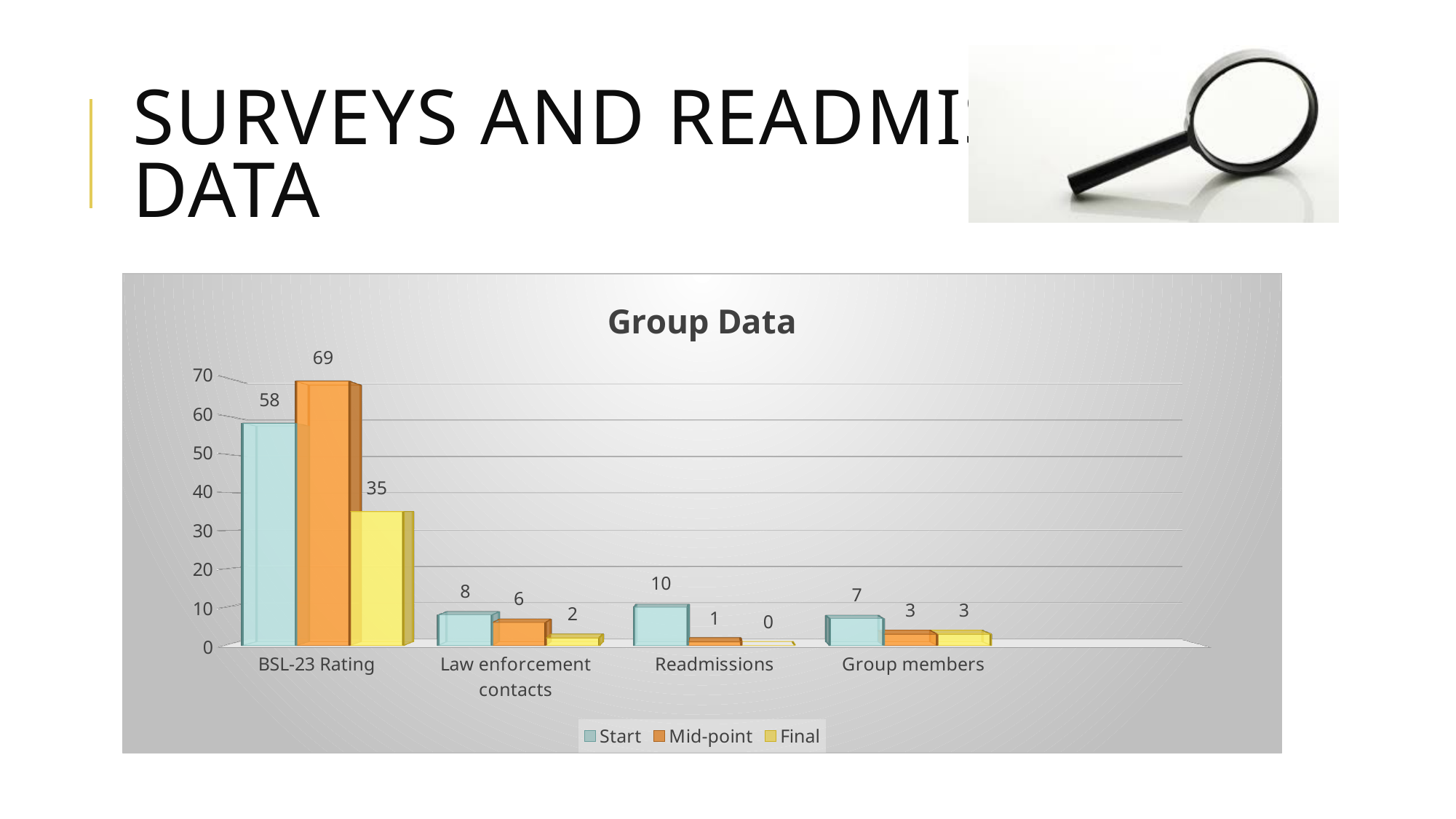
How many series does the legend list? 3 How many categories are shown on the x axis? 4 What is the title of the chart? Group Data Which category has the lowest Final value? Readmissions What is the Final value for Readmissions? 0 What is the Mid-point value for BSL-23 Rating? 69 Which category has the highest Start value? BSL-23 Rating What is the difference between the Start and Final values for BSL-23 Rating? 23 What is the Final value for Law enforcement contacts? 2 What is the Start value for Readmissions? 10 Which is larger for Group members: the Start value or the Mid-point value? Start What kind of chart is shown on the slide? Bar chart